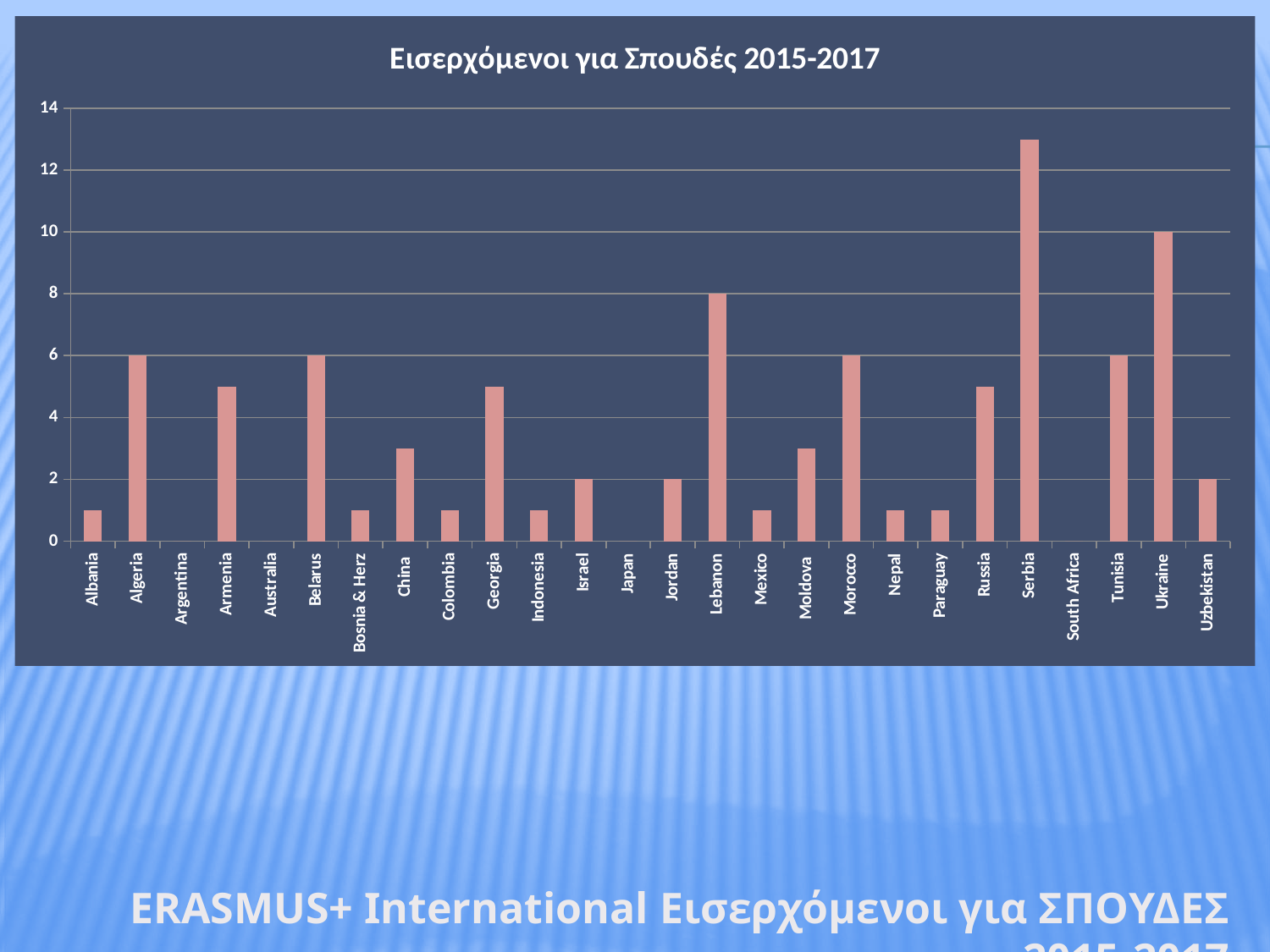
What is the value for Morocco? 6 Is the value for Serbia greater or less than 12? greater How many countries are listed on the x axis of the chart? 26 What is the title of the chart? Εισερχόμενοι για Σπουδές 2015-2017 Which has a larger value, Lebanon or Morocco? Lebanon What is the value for Lebanon? 8 Is the value for China greater or less than 4? less What is the value for Ukraine? 10 What is the difference between the values for Ukraine and Lebanon? 2 What type of chart is shown on the slide? bar chart What is the value for Israel? 2 Which country has the highest value in the chart? Serbia